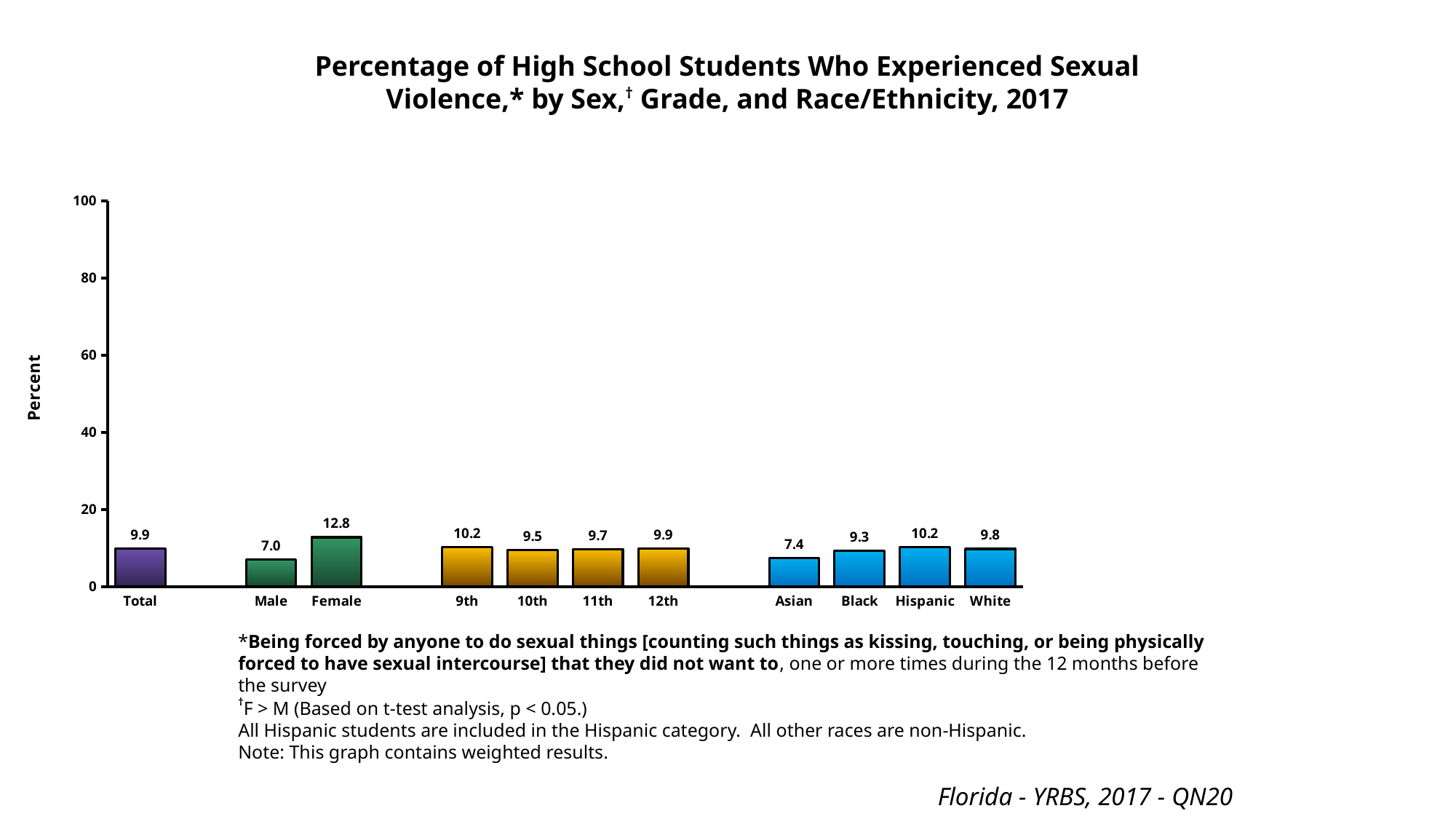
What is the value for Female? 12.8 What kind of chart is shown? bar chart What is the difference between the Female and Male values? 5.8 What is the value for 10th grade? 9.5 Is the value for Hispanic greater or less than 20? less What is the label on the y axis? Percent What is the value for Asian? 7.4 Which is larger, the value for Black or the value for Asian? Black Which category has the lowest value? Male What is the value for Male? 7.0 Which category has the highest value? Female How many categories are plotted on the chart? 11